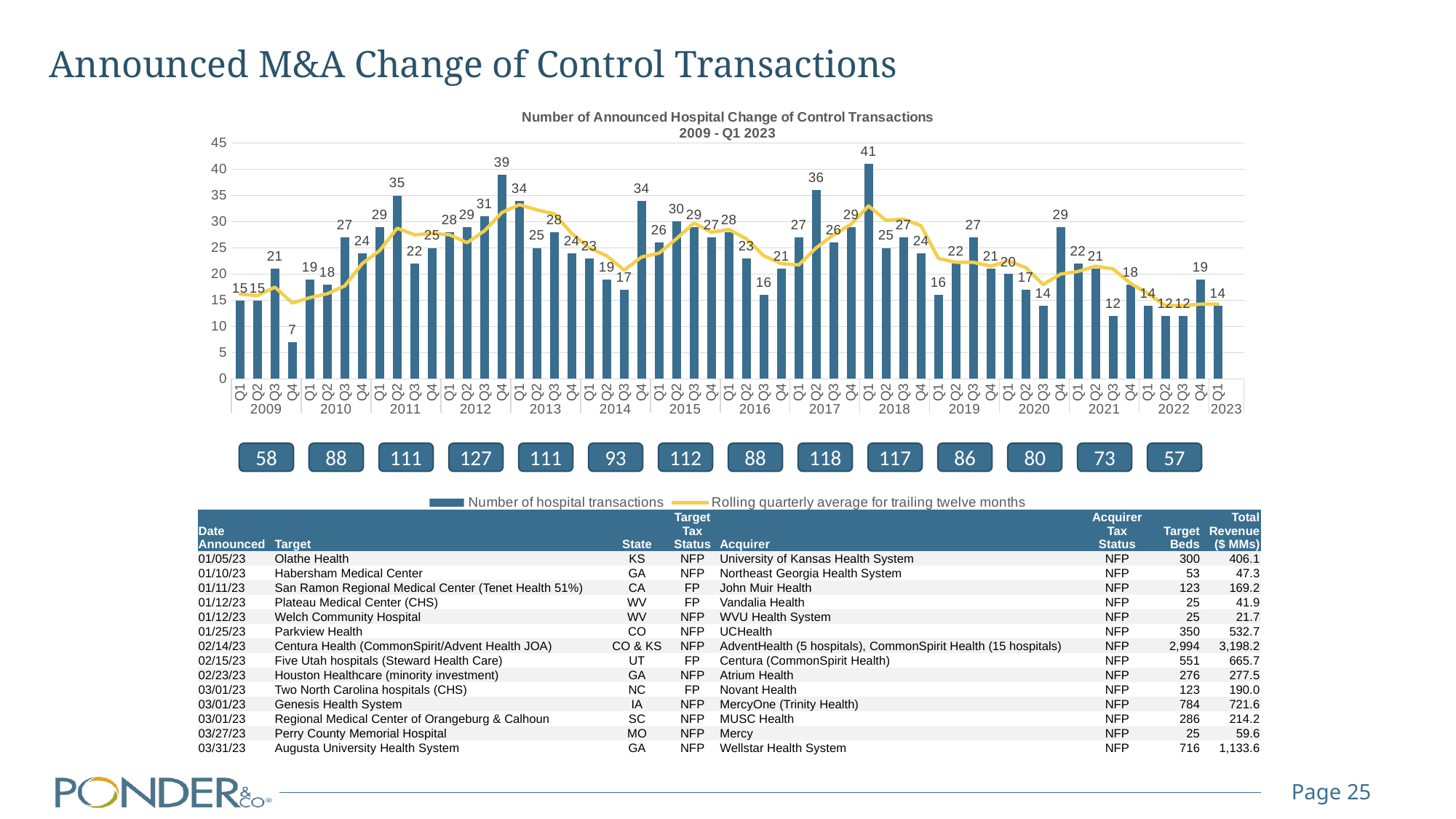
Which quarter had more hospital transactions, Q2 2017 or Q2 2011? Q2 2017 What is the difference between the annual totals for 2012 and 2022? 70 Which quarter has the highest number of hospital transactions? Q1 2018 How many series does the chart legend list? 2 What type of chart is used to show the number of hospital transactions per quarter? bar chart (with a line overlay) What is the difference between the number of hospital transactions in Q1 2018 and Q4 2009? 34 What is the annual total of hospital transactions shown for 2012? 127 What is the number of hospital transactions in Q1 2023? 14 Which quarter has the lowest number of hospital transactions? Q4 2009 What does the yellow line in the chart represent? Rolling quarterly average for trailing twelve months What is the annual total of hospital transactions shown for 2022? 57 What is the number of hospital transactions in Q4 2012? 39